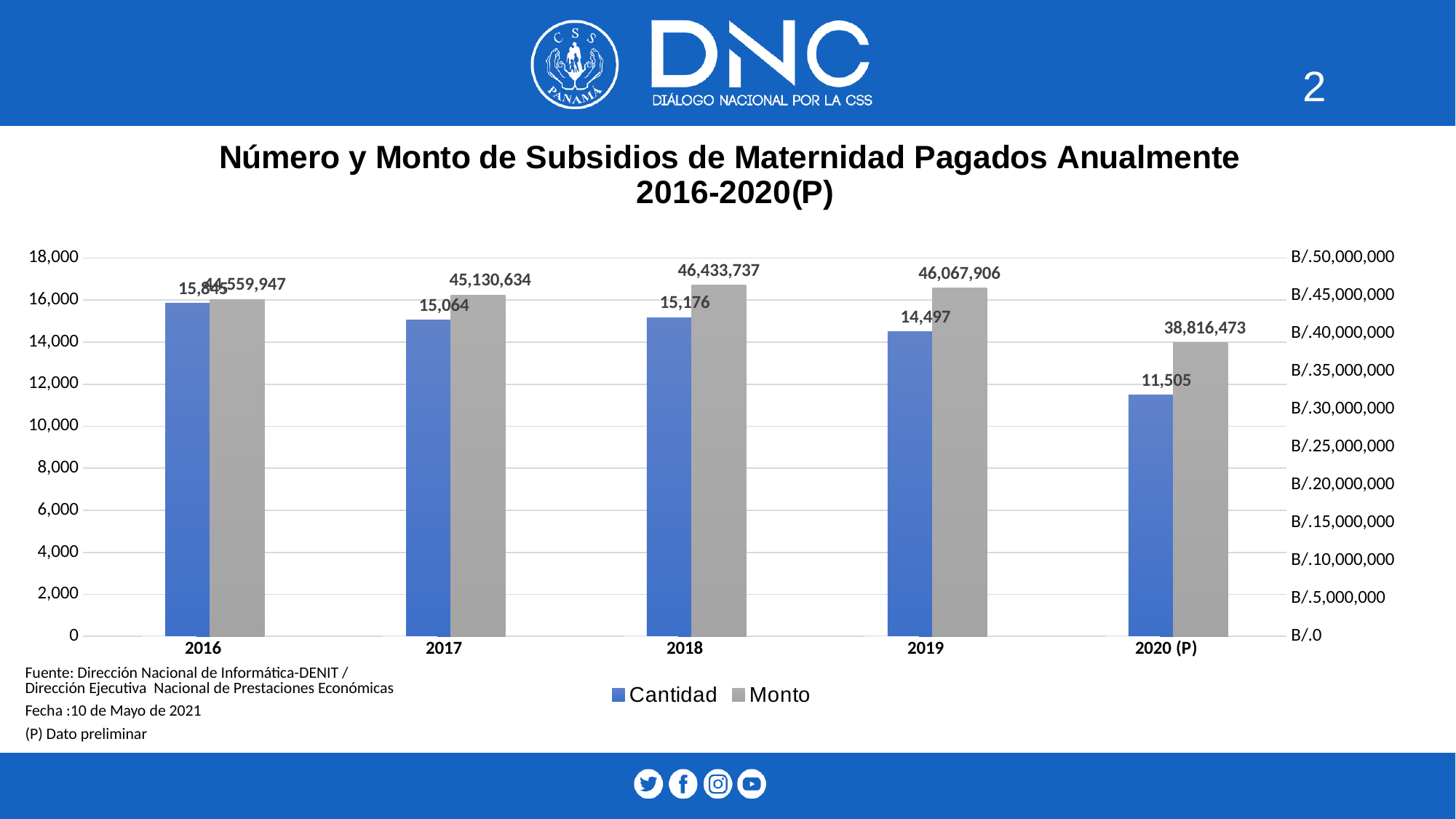
What is the difference between the Monto values for 2018 and 2019? 365,831 Is the Cantidad value for 2020 (P) greater or less than 12,000? less What is the Cantidad value for 2019? 14,497 How many years are shown on the x axis? 5 Which year has the lowest Cantidad value? 2020 (P) What is the Cantidad value for 2020 (P)? 11,505 Which year has the highest Monto value? 2018 How many series does the legend list? 2 What is the Monto value for 2018? 46,433,737 What kind of chart is shown on the slide? bar chart What is the difference between the Cantidad values for 2019 and 2020 (P)? 2,992 Which is larger, the Cantidad value for 2017 or for 2018? 2018